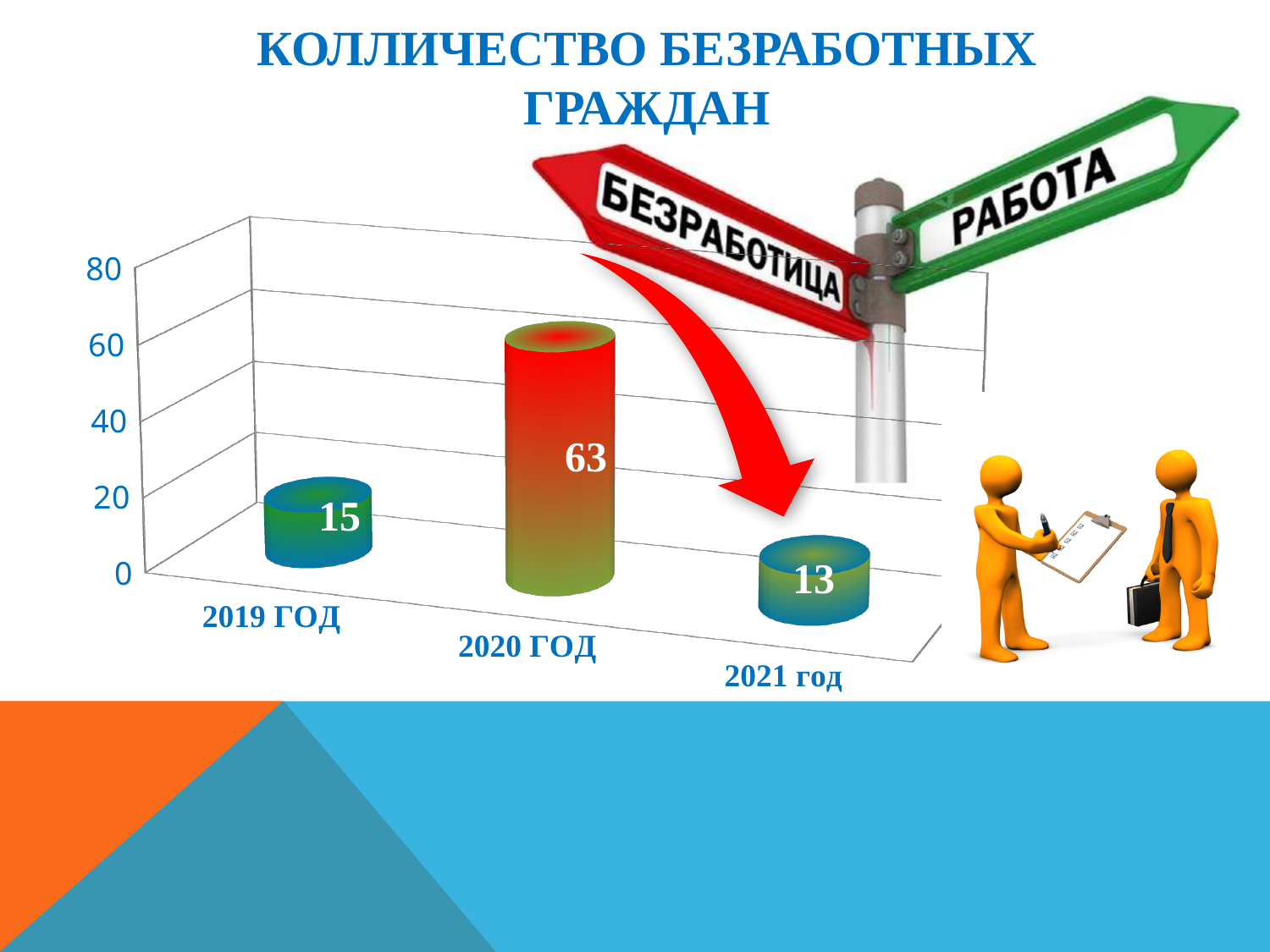
What is the difference between the values for 2020 ГОД and 2021 год? 50 Is the value for 2020 ГОД greater or less than 40? greater Which year has the lowest number of unemployed citizens? 2021 год Which is larger, the value for 2019 ГОД or the value for 2020 ГОД? 2020 ГОД What kind of chart is shown on the slide? bar chart Which year has the highest number of unemployed citizens? 2020 ГОД What is the value for 2020 ГОД? 63 How many categories (years) are shown on the chart? 3 What is the value for 2019 ГОД? 15 What is the difference between the values for 2019 ГОД and 2021 год? 2 What is the title of the slide? КОЛЛИЧЕСТВО БЕЗРАБОТНЫХ ГРАЖДАН What is the value for 2021 год? 13